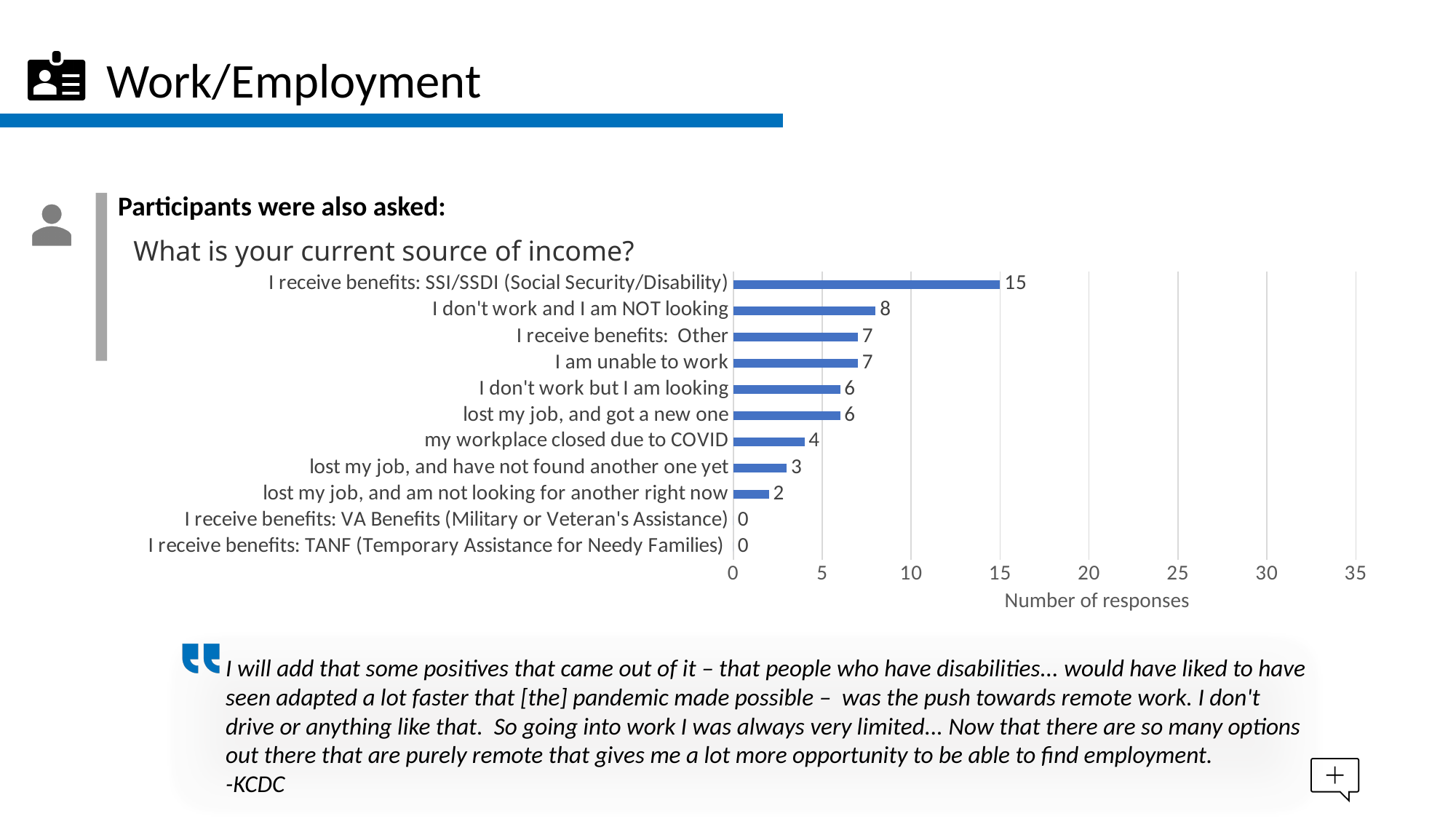
What kind of chart is shown on the slide? bar chart Is the value for "I receive benefits: Other" greater or less than 10? less What is the value for "lost my job, and am not looking for another right now"? 2 Which category has the highest number of responses? I receive benefits: SSI/SSDI (Social Security/Disability) How many responses does "my workplace closed due to COVID" have? 4 How many responses are shown for "I receive benefits: SSI/SSDI (Social Security/Disability)"? 15 What is the label of the horizontal axis? Number of responses How many categories are shown in the chart? 11 How many categories have 0 responses? 2 What is the number of responses for "I don't work and I am NOT looking"? 8 What is the difference in responses between "I receive benefits: SSI/SSDI (Social Security/Disability)" and "I don't work and I am NOT looking"? 7 Which has more responses, "I don't work but I am looking" or "lost my job, and have not found another one yet"? I don't work but I am looking